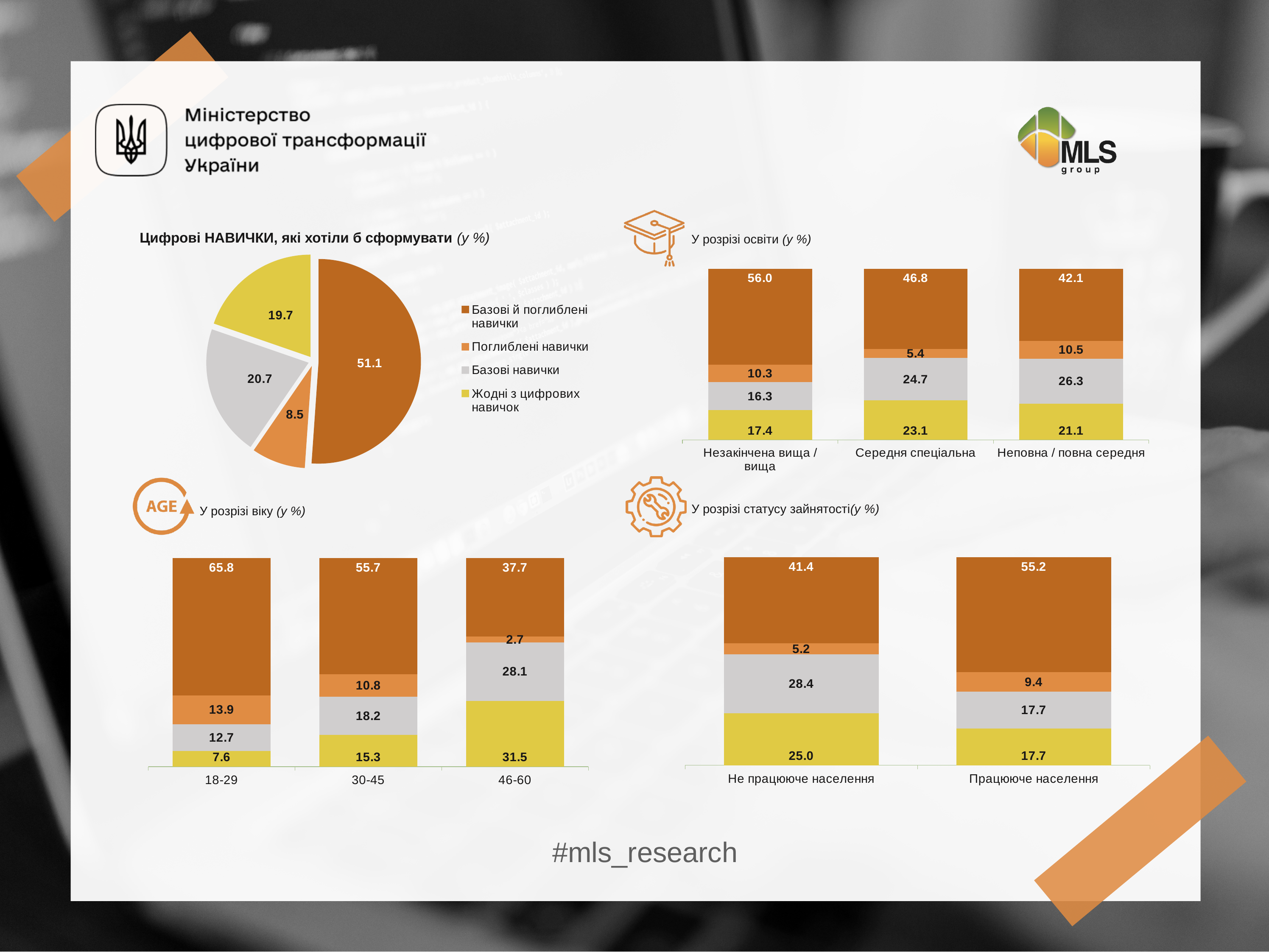
In the pie chart 'Цифрові НАВИЧКИ, які хотіли б сформувати', which category has the smallest slice? Поглиблені навички What kind of chart is 'У розрізі віку (у %)'? Stacked bar chart How many entries does the legend of the pie chart 'Цифрові НАВИЧКИ, які хотіли б сформувати' list? 4 In the chart 'У розрізі віку (у %)', what is the difference between the top (dark orange) segment values for '18-29' and '46-60'? 28.1 In the pie chart 'Цифрові НАВИЧКИ, які хотіли б сформувати', what is the value for 'Базові й поглиблені навички'? 51.1 In the chart 'У розрізі віку (у %)', does the top (dark orange) segment value rise or fall from '18-29' to '46-60'? Fall In the chart 'У розрізі освіти (у %)', which category has the highest value for the bottom (yellow) segment? Середня спеціальна In the chart 'У розрізі освіти (у %)', what is the value of the top (dark orange) segment for 'Середня спеціальна'? 46.8 In the chart 'У розрізі статусу зайнятості (у %)', what is the value of the grey segment for 'Не працююче населення'? 28.4 How many categories are shown on the x axis of the chart 'У розрізі статусу зайнятості (у %)'? 2 In the chart 'У розрізі статусу зайнятості (у %)', which category has the larger top (dark orange) segment value: 'Не працююче населення' or 'Працююче населення'? Працююче населення In the chart 'У розрізі віку (у %)', what is the value of the bottom (yellow) segment for '46-60'? 31.5